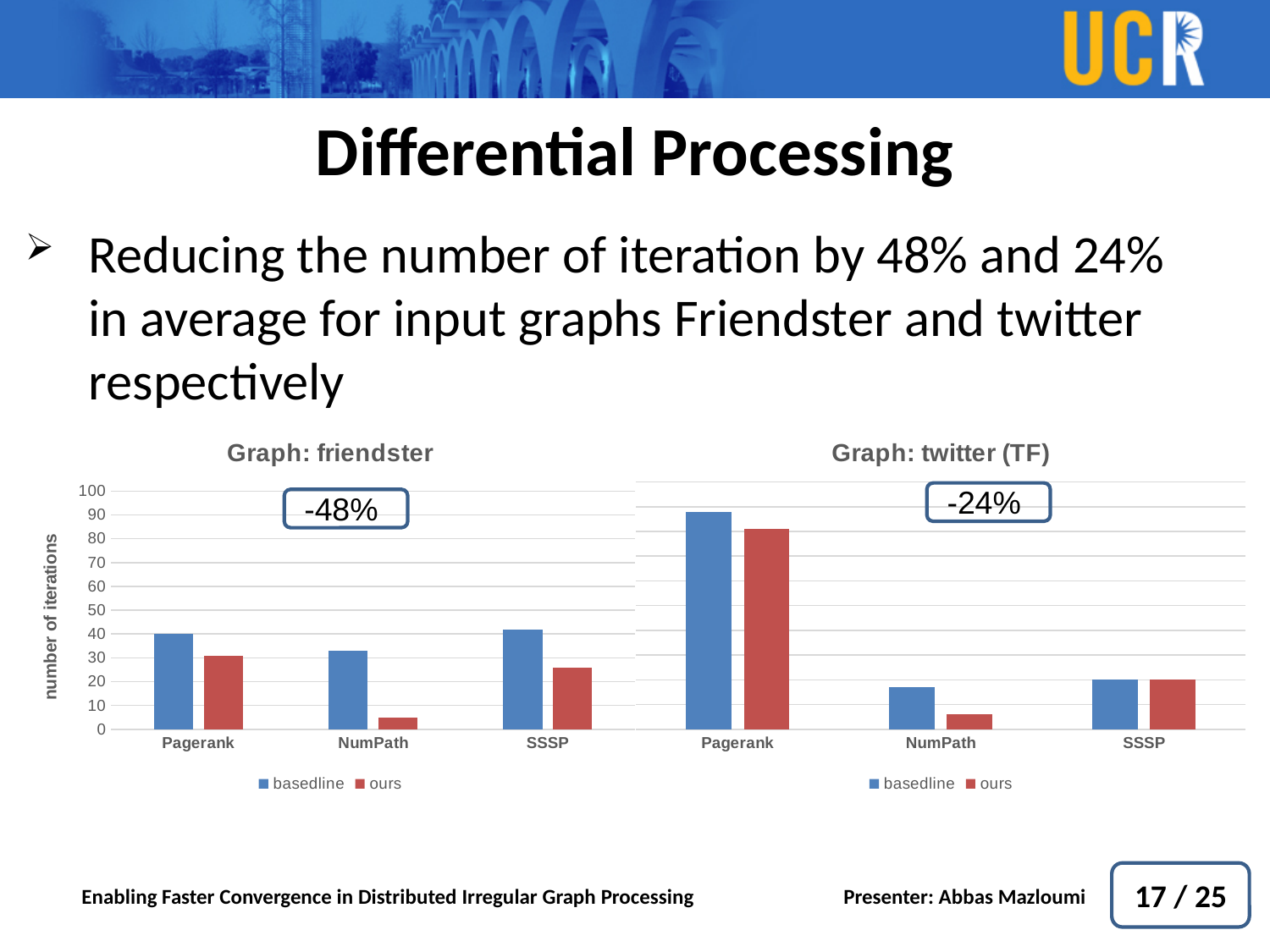
In the 'Graph: friendster' chart, what kind of chart is shown? bar chart In the 'Graph: twitter (TF)' chart, which category has the lowest ours value? NumPath In the 'Graph: twitter (TF)' chart, which category has the highest baseline value? Pagerank In the 'Graph: friendster' chart, which category has the lowest ours value? NumPath In the 'Graph: friendster' chart, is the ours value for NumPath greater or less than 10? less In the 'Graph: twitter (TF)' chart, is the ours value for NumPath greater or less than 10? less In the 'Graph: twitter (TF)' chart, how many categories are shown on the x axis? 3 In the 'Graph: friendster' chart, how many series does the legend list? 2 In the 'Graph: friendster' chart, is the baseline value for NumPath greater or less than 30? greater In the 'Graph: friendster' chart, which is larger for SSSP, basedline or ours? basedline What is the y-axis label of the 'Graph: friendster' chart? number of iterations